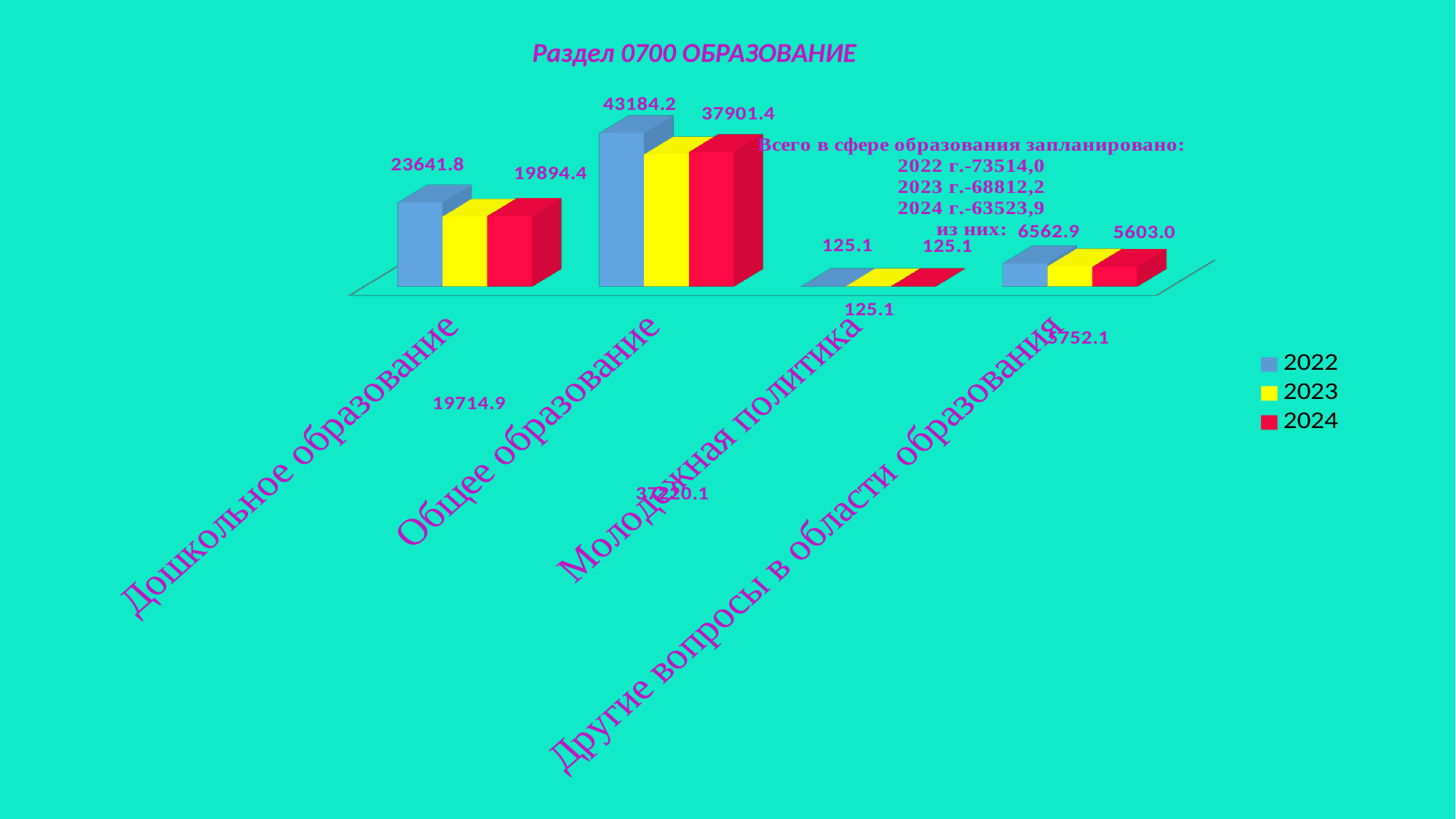
How many categories are shown on the x axis? 4 What is the value for Общее образование in 2024? 37901.4 What is the value for Общее образование in 2022? 43184.2 What is the value for Другие вопросы в области образования in 2024? 5603.0 What kind of chart is shown on the slide? bar chart What is the title of the chart? Раздел 0700 ОБРАЗОВАНИЕ How many series does the legend list? 3 Which category has the lowest value for 2022? Молодежная политика What is the value for Молодежная политика in 2024? 125.1 Which category has the highest value for 2022? Общее образование What is the difference between the 2022 and 2024 values for Дошкольное образование? 3747.4 What is the value for Дошкольное образование in 2022? 23641.8